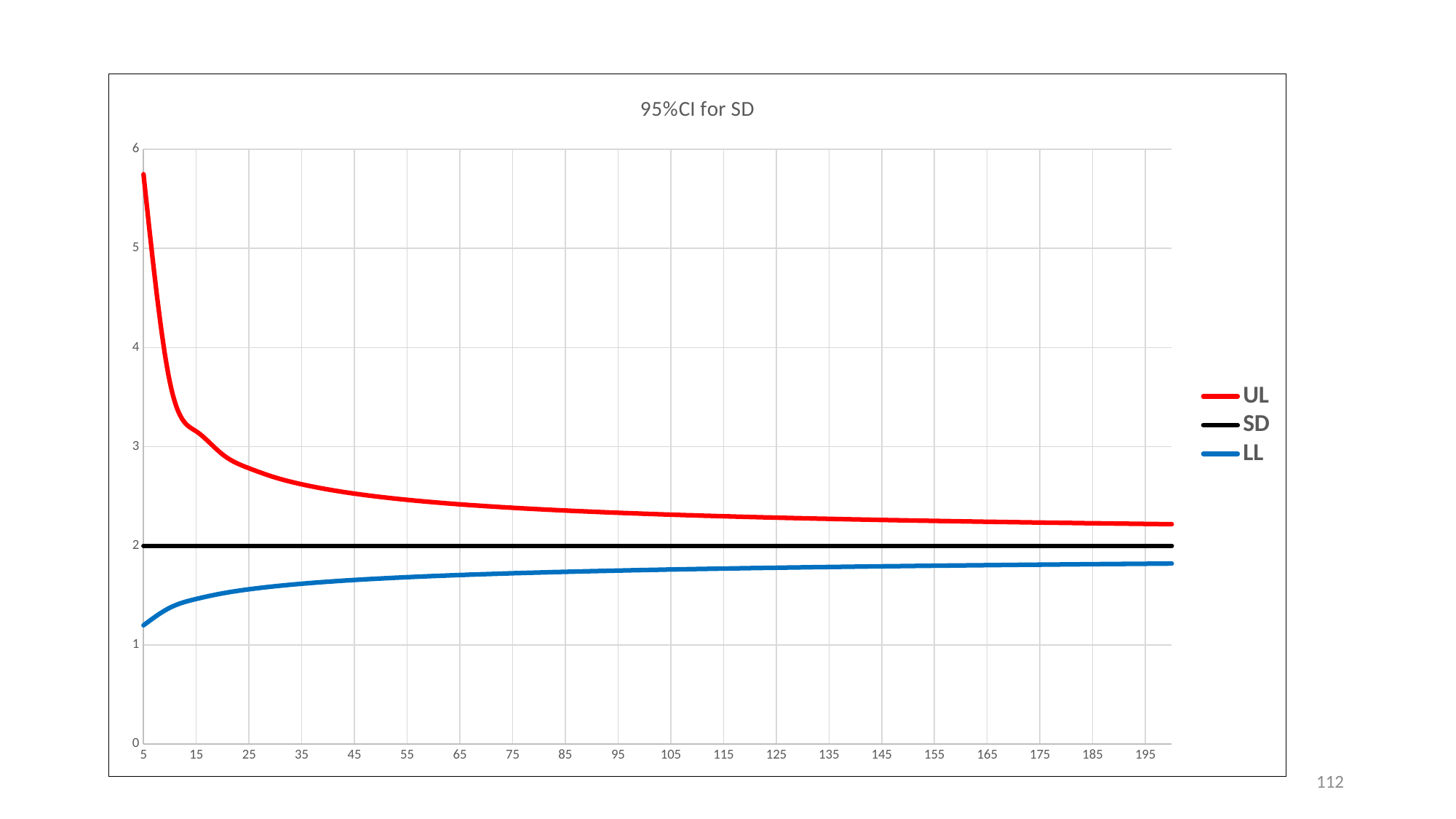
Is the value of UL at x = 5 greater or less than 5? greater Does the LL series rise or fall as x increases? rise Is the value of LL at x = 195 greater or less than 2? less Is the value of UL at x = 195 greater or less than 3? less At x = 105, which series has the larger value, UL or LL? UL How many series does the legend list? 3 What is the title of the chart? 95%CI for SD Does the UL series rise or fall as x increases? fall What is the value of the SD series across the x axis? 2 Which series is drawn in red? UL What kind of chart is shown on the slide? line chart